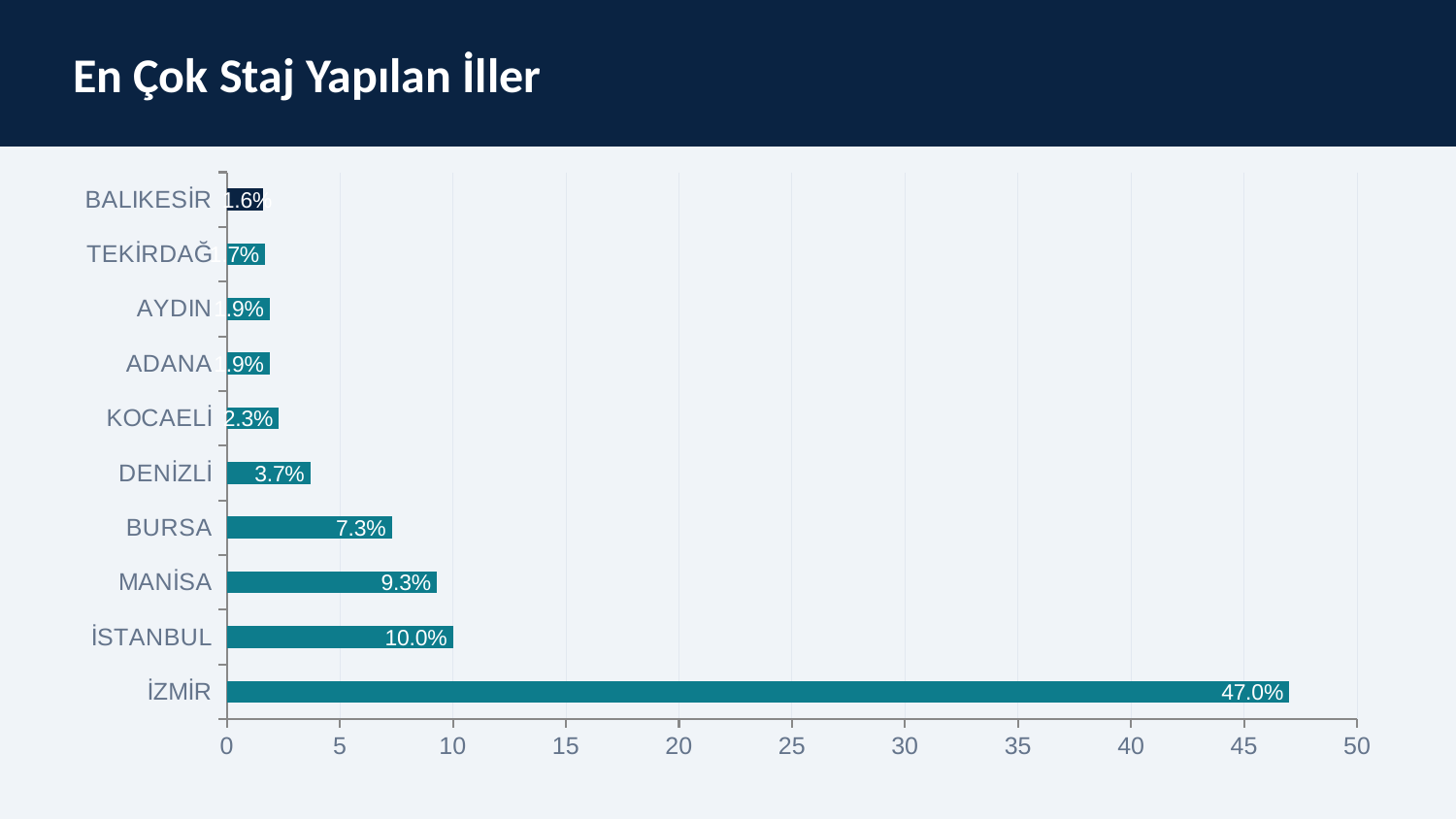
What is the value for BURSA? 7.3% What is the difference between the values for MANİSA and BURSA? 2.0% What is the value for DENİZLİ? 3.7% How many provinces are shown in the chart? 10 What is the title of the slide? En Çok Staj Yapılan İller What is the value for İZMİR? 47.0% What is the difference between the values for İZMİR and İSTANBUL? 37.0% What is the value for İSTANBUL? 10.0% Which province has the highest value? İZMİR Which is larger, the value for İSTANBUL or the value for MANİSA? İSTANBUL What kind of chart is shown on the slide? bar chart Is the value for İZMİR greater or less than 45? greater